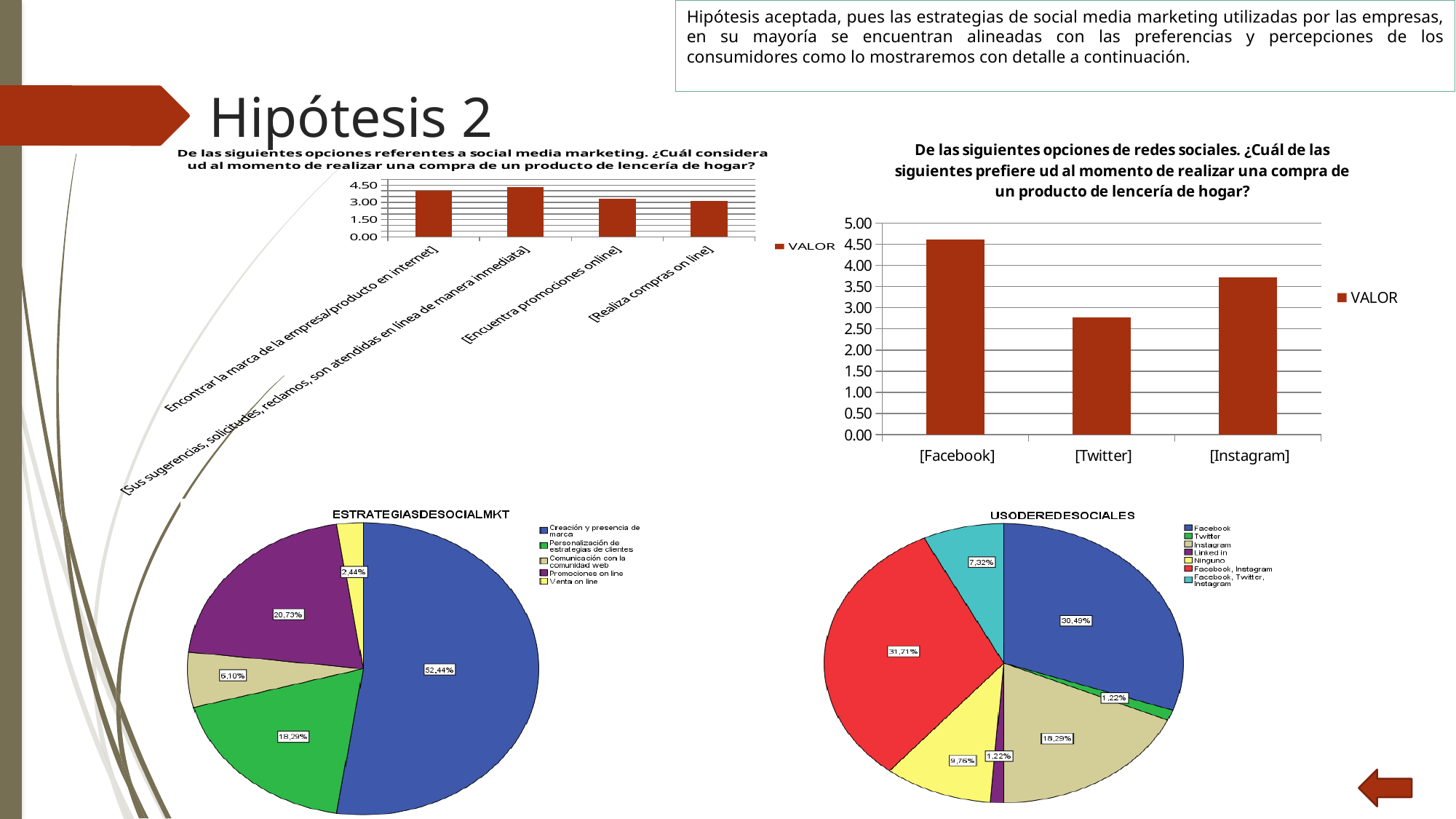
How many categories are shown in the top-left bar chart titled 'De las siguientes opciones referentes a social media marketing...'? 4 In the pie chart titled USODEREDESOCIALES, which legend entry has the largest slice? Facebook, Instagram What kind of chart is the top-left chart titled 'De las siguientes opciones referentes a social media marketing...'? bar chart In the bar chart titled 'De las siguientes opciones de redes sociales...', is the value for [Twitter] greater or less than 3.00? less How many entries does the legend of the pie chart titled USODEREDESOCIALES list? 7 In the bar chart titled 'De las siguientes opciones de redes sociales...', which social network has the lowest value? [Twitter] In the bar chart titled 'De las siguientes opciones de redes sociales...', which social network has the highest value? [Facebook] In the pie chart titled ESTRATEGIASDESOCIALMKT, what is the difference between the largest slice (52,44%) and the 'Promociones on line' slice (20,73%)? 31,71% How many categories are shown in the bar chart titled 'De las siguientes opciones de redes sociales...'? 3 In the pie chart titled ESTRATEGIASDESOCIALMKT, what share does 'Promociones on line' have? 20,73% In the bar chart titled 'De las siguientes opciones de redes sociales...', is the value for [Facebook] greater or less than 4.00? greater In the top-left bar chart titled 'De las siguientes opciones referentes a social media marketing...', which category has the highest value? [Sus sugerencias, solicitudes, reclamos, son atendidas en línea de manera inmediata]